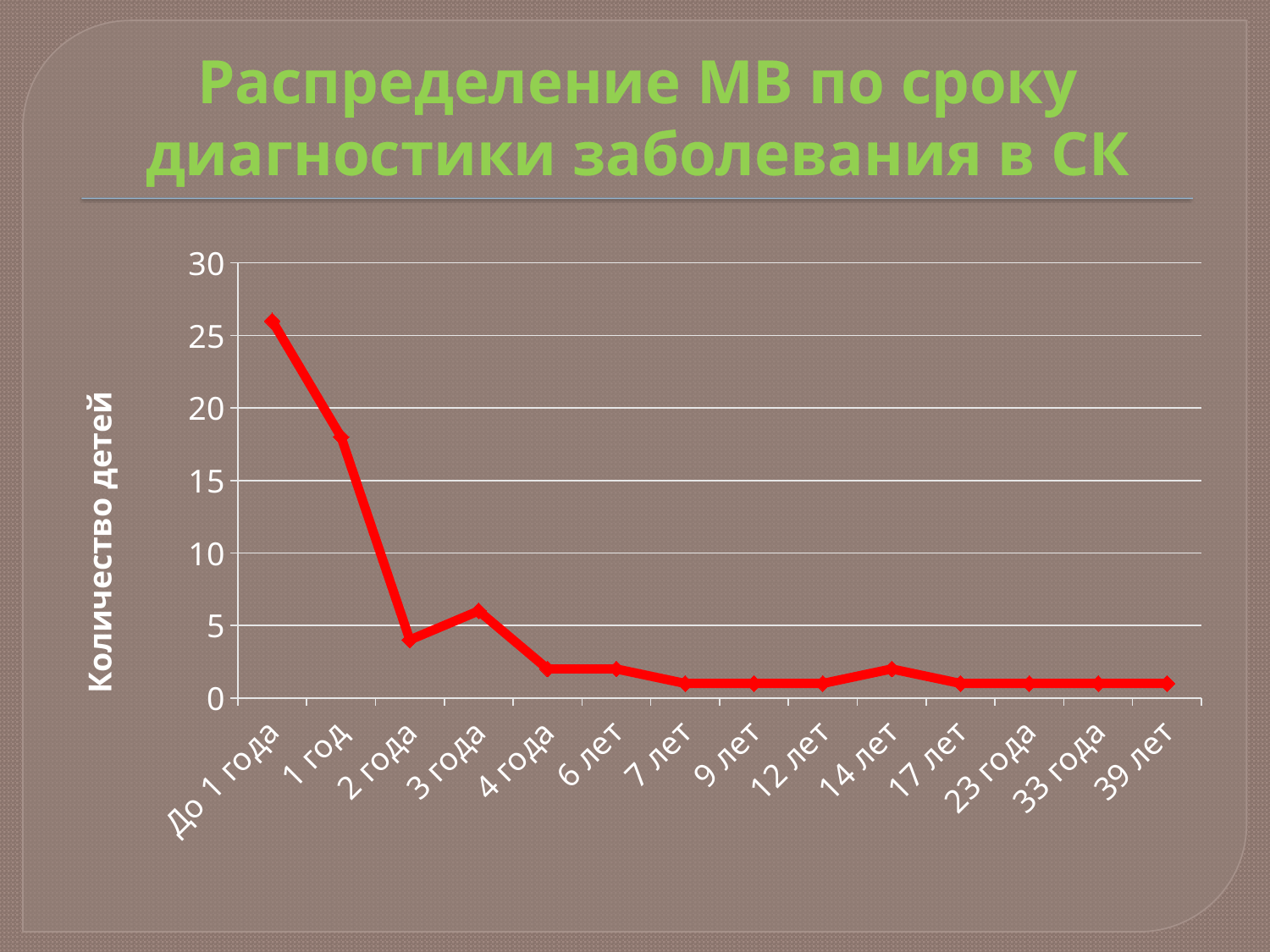
Which is larger, the value for 2 года or the value for 3 года? 3 года Is the value for 1 год greater or less than 15? greater Is the value for 2 года greater or less than 5? less Is the value for 1 год greater or less than 20? less Do the values generally rise or fall from left to right along the x axis? fall What kind of chart is shown on the slide? line chart Which category has the highest value? До 1 года How many categories are plotted along the x axis? 14 What is the title of the chart? Распределение МВ по сроку диагностики заболевания в СК What is the label of the vertical axis? Количество детей